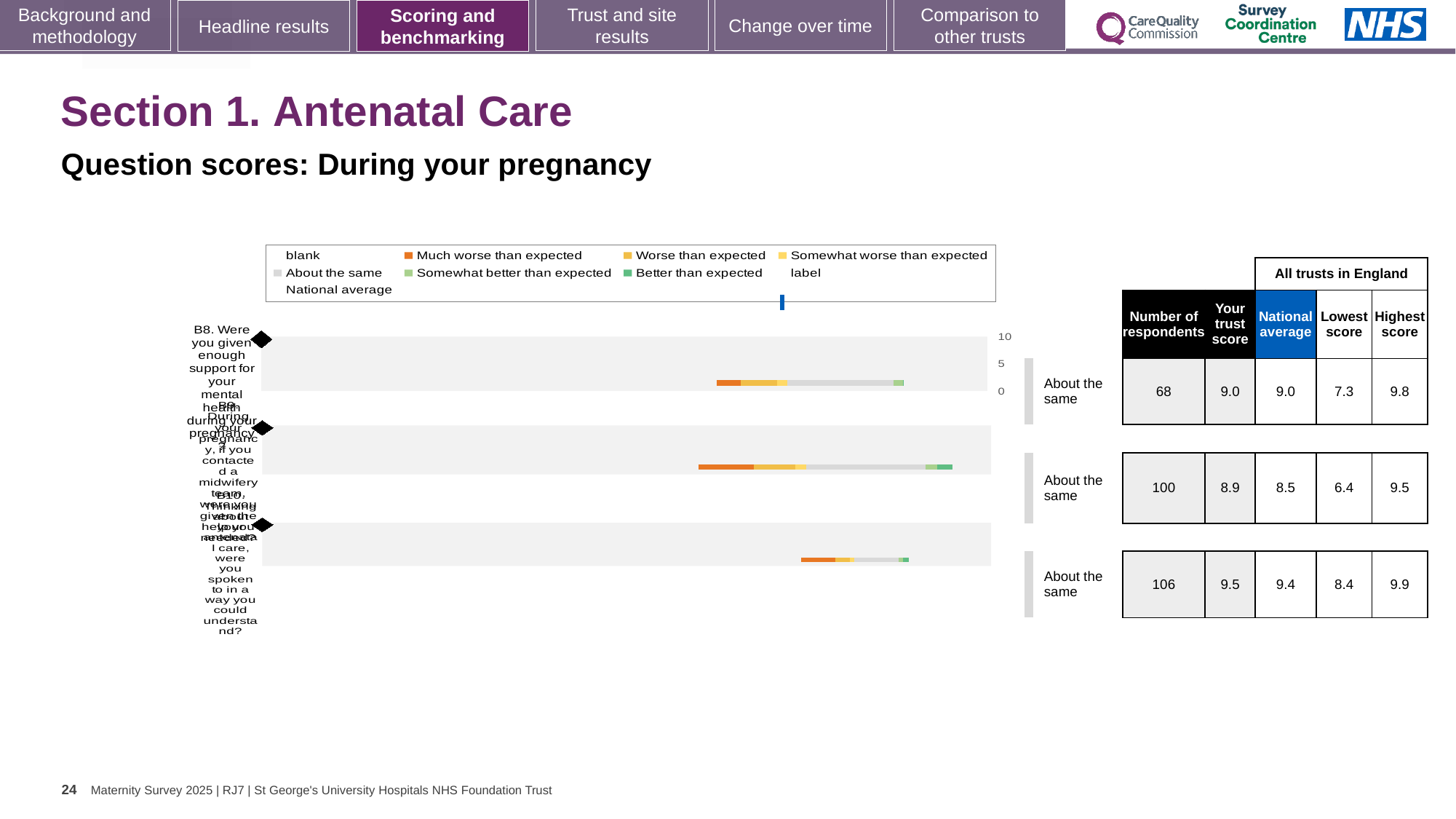
What kind of chart is shown on the slide? bar chart How many question rows (bars) does the chart show? 3 How many of the chart's rows are labelled 'About the same'? 3 What benchmark category is shown next to the chart for question B8? About the same According to the table beside the chart, how many respondents answered question B8 (support for your mental health during pregnancy)? 68 What is the national average for the top row (B8) in the table beside the chart? 9.0 For the middle row, which is larger: the trust score or the national average? the trust score (8.9) For the middle row, what is the difference between the highest score (9.5) and the lowest score (6.4) in the table? 3.1 What is the lowest score for the bottom row in the table beside the chart? 8.4 What is the trust score for question B8 (support for your mental health during pregnancy) in the table beside the chart? 9.0 Which row of the chart has the highest number of respondents in the table? the bottom row (106) Which legend entry is shown in dark orange? Much worse than expected